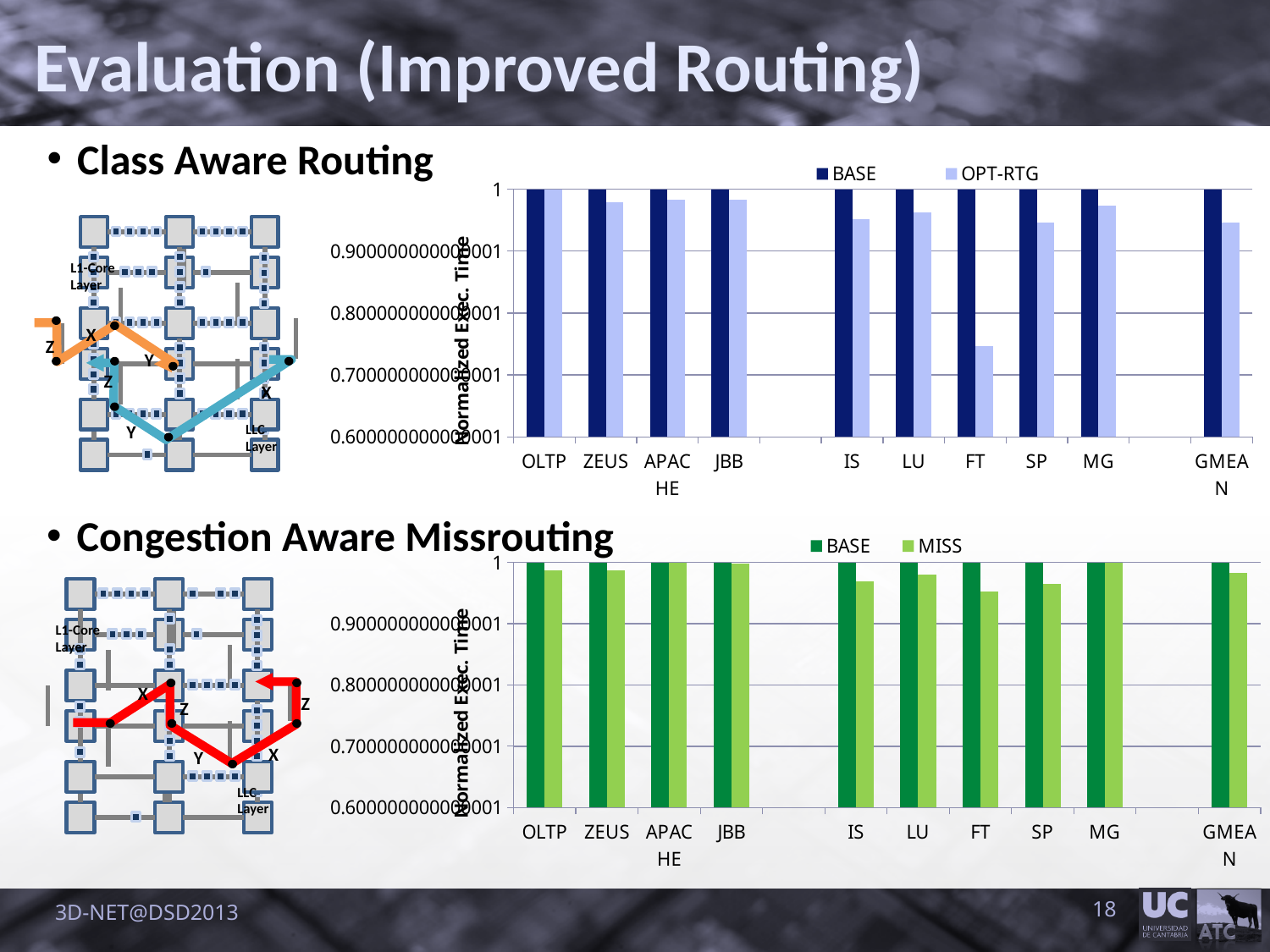
In the bottom chart (Congestion Aware Missrouting), which is larger, the MISS value for MG or for FT? MG In the top chart (Class Aware Routing), what are the two series named in the legend? BASE and OPT-RTG In the top chart (Class Aware Routing), what is the BASE value for OLTP? 1 In the top chart (Class Aware Routing), how many categories are shown on the x axis? 10 In the bottom chart (Congestion Aware Missrouting), what is the BASE value for GMEAN? 1 In the bottom chart (Congestion Aware Missrouting), is the MISS value for FT greater or less than 0.9? greater In the top chart (Class Aware Routing), which category has the lowest OPT-RTG value? FT In the top chart (Class Aware Routing), what kind of chart is shown? bar chart In the top chart (Class Aware Routing), is the OPT-RTG value for FT greater or less than 0.8? less In the top chart (Class Aware Routing), how many series does the legend list? 2 In the top chart (Class Aware Routing), which is larger, the OPT-RTG value for ZEUS or for FT? ZEUS In the bottom chart (Congestion Aware Missrouting), what are the two series named in the legend? BASE and MISS